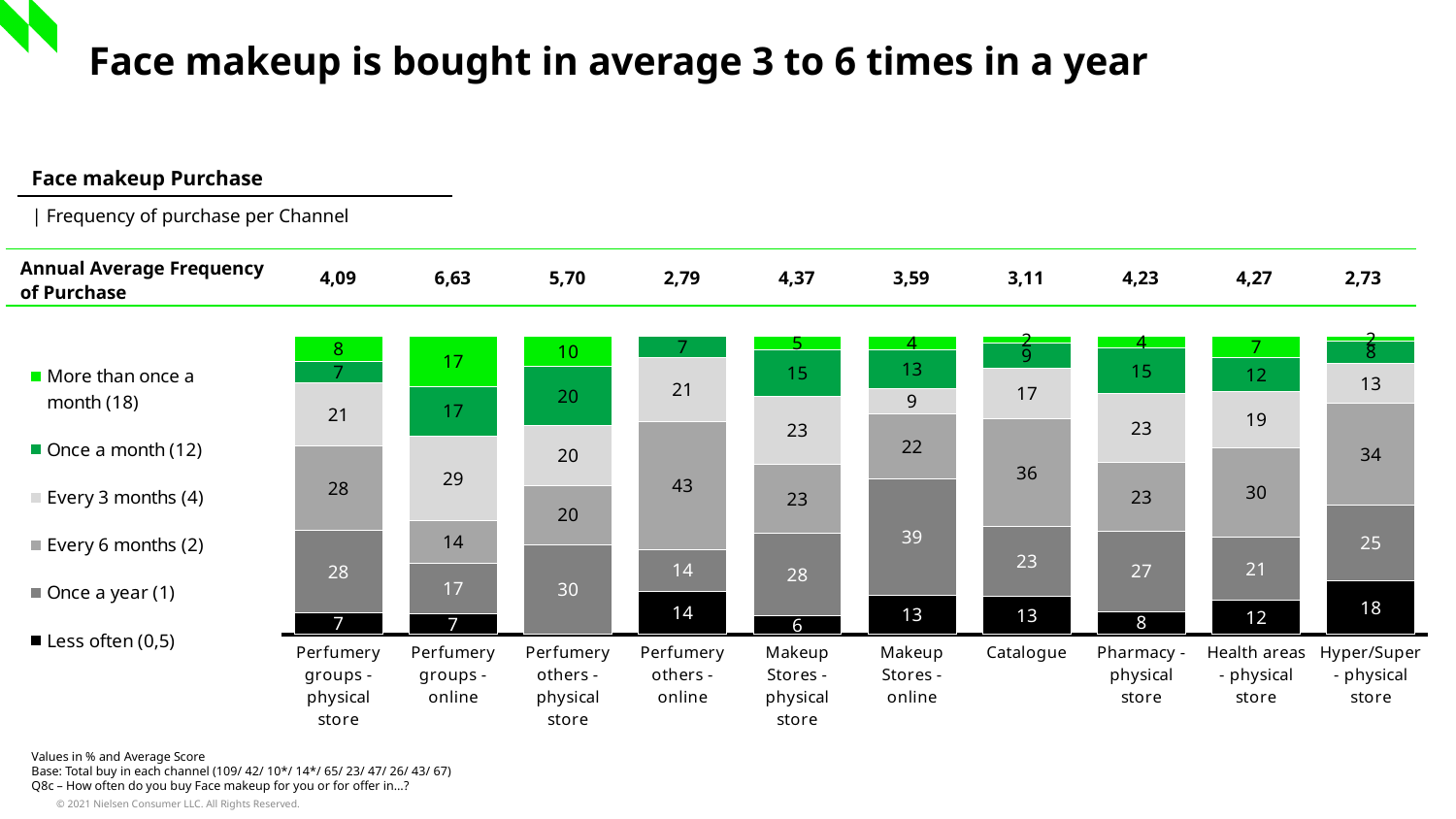
Which channel has the lowest Annual Average Frequency of Purchase? Hyper/Super - physical store What is the Annual Average Frequency of Purchase for Perfumery groups - online? 6,63 Which legend entry is shown in the brightest green colour? More than once a month (18) What percentage of Perfumery others - online buyers purchase Every 6 months? 43 What percentage of Makeup Stores - online buyers purchase Once a year? 39 What is the difference between the Every 6 months values for Catalogue and Perfumery groups - physical store? 8 How many series does the chart's legend list? 6 How many channels (categories) are shown along the x axis of the chart? 10 Which is larger: the Once a year value for Perfumery others - physical store or for Health areas - physical store? Perfumery others - physical store What is the value for Less often in the Hyper/Super - physical store bar? 18 What type of chart is shown on the slide? Stacked bar chart Which channel has the highest Annual Average Frequency of Purchase? Perfumery groups - online